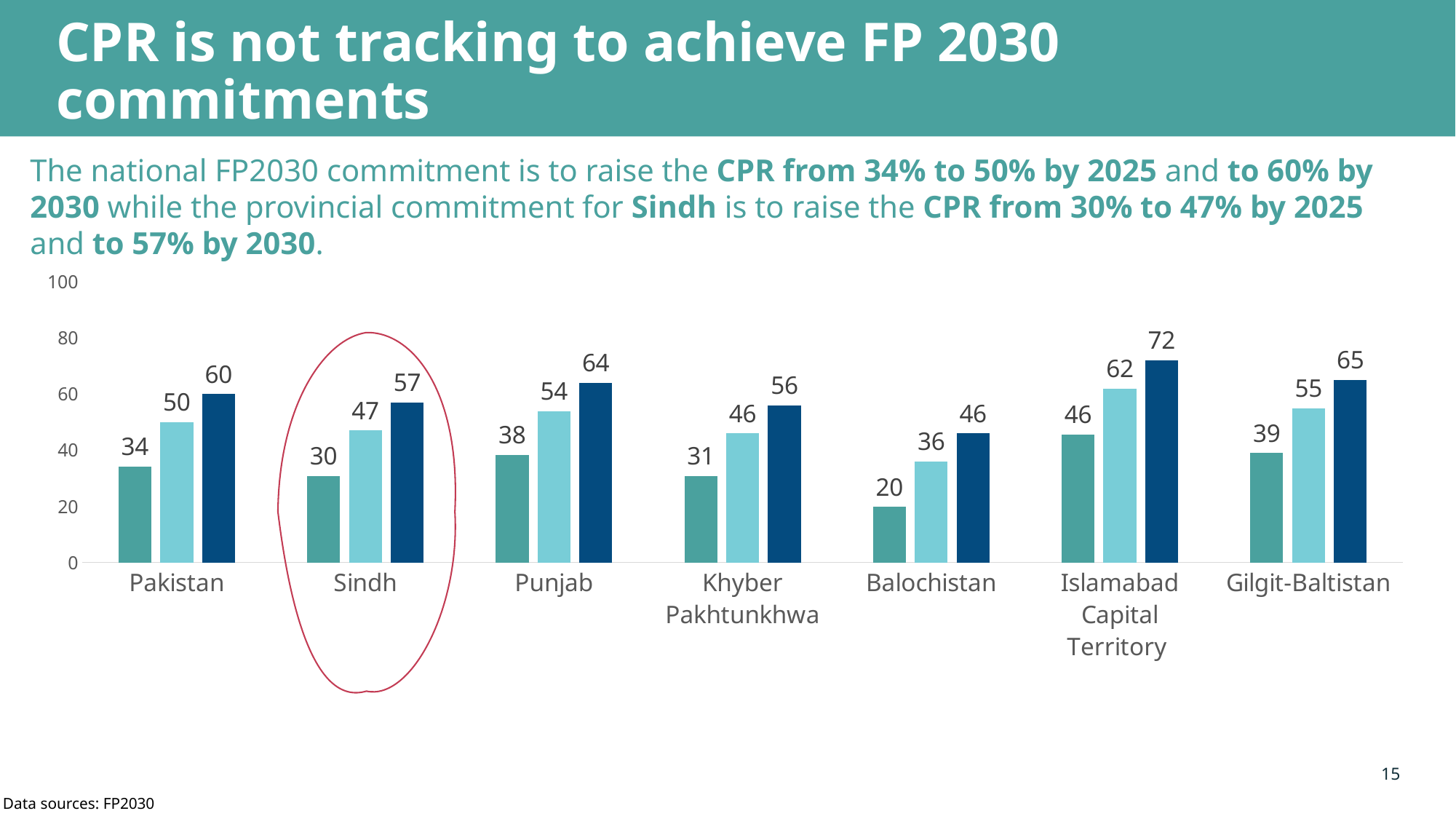
What is the value of the first (dark teal) bar for Balochistan? 20 Which region has the highest value for the third (dark navy) bar? Islamabad Capital Territory Which region on the chart is circled in red? Sindh Is the value of the third (dark navy) bar for Balochistan greater or less than 60? less Which region has the lowest value for the first (dark teal) bar? Balochistan Which is larger: the middle (light blue) bar for Gilgit-Baltistan or the middle (light blue) bar for Khyber Pakhtunkhwa? Gilgit-Baltistan How many bars are shown for each region in the chart? 3 What is the value of the third (dark navy) bar for Islamabad Capital Territory? 72 How many categories (regions) are shown on the x axis of the chart? 7 What is the value of the middle (light blue) bar for Punjab? 54 What is the difference between the third (dark navy) bar and the first (dark teal) bar for Sindh? 27 What type of chart is shown on the slide? Bar chart